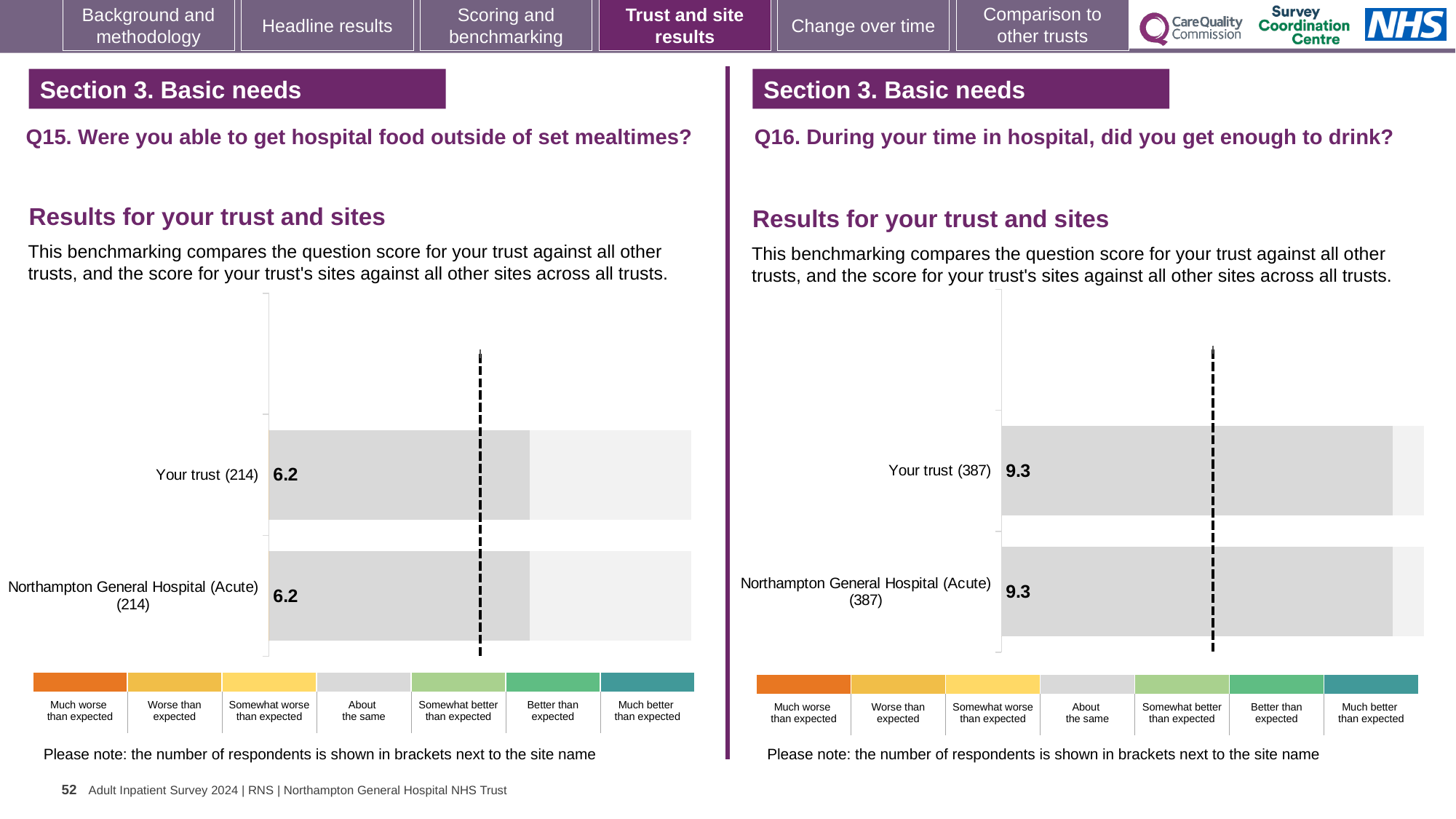
How many bars are plotted on the Q16 chart (right)? 2 On the Q15 chart (left), what is the score for Your trust? 6.2 On the Q15 chart (left), what is the difference between the score for Your trust and the score for Northampton General Hospital (Acute)? 0.0 On the Q16 chart (right), what is the score for Your trust? 9.3 How many bars are plotted on the Q15 chart (left)? 2 On the Q15 chart (left), how many respondents are shown in brackets for Your trust? 214 On the Q15 chart (left), what is the score for Northampton General Hospital (Acute)? 6.2 On the Q16 chart (right), what is the score for Northampton General Hospital (Acute)? 9.3 What kind of chart is used on the Q15 chart (left)? Bar chart On the Q16 chart (right), what is the difference between the score for Your trust and the score for Northampton General Hospital (Acute)? 0.0 On the Q16 chart (right), how many respondents are shown in brackets for Northampton General Hospital (Acute)? 387 Is the score for Your trust on the Q16 chart (right) larger or smaller than the score for Your trust on the Q15 chart (left)? Larger